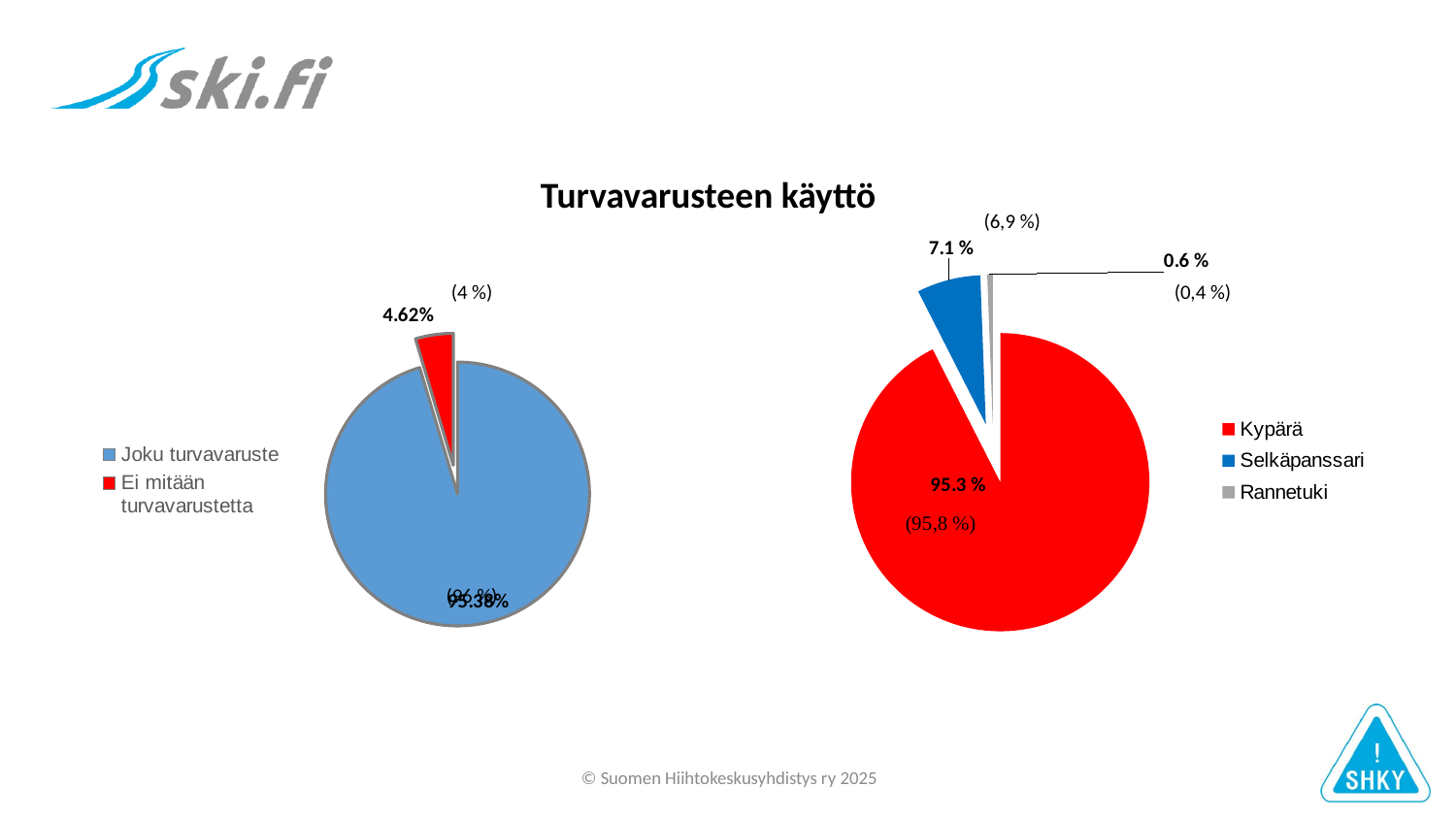
In the right pie chart, which category has the largest slice? Kypärä What colour is the Kypärä slice in the right pie chart? Red In the right pie chart, what is the difference between the values for Selkäpanssari and Rannetuki? 6.5 % How many categories does the legend of the right pie chart list? 3 In the right pie chart, what value is shown for Selkäpanssari? 7.1 % In the right pie chart, what value is shown for Kypärä? 95.3 % In the left pie chart, what share is shown for 'Ei mitään turvavarustetta'? 4.62% In the left pie chart, what share is shown for 'Joku turvavaruste'? 95.38% In the right pie chart, what value is shown for Rannetuki? 0.6 % What type of chart is the left chart on the slide? Pie chart In the right pie chart, which category has the smallest slice? Rannetuki In the left pie chart, which is larger: 'Joku turvavaruste' or 'Ei mitään turvavarustetta'? Joku turvavaruste